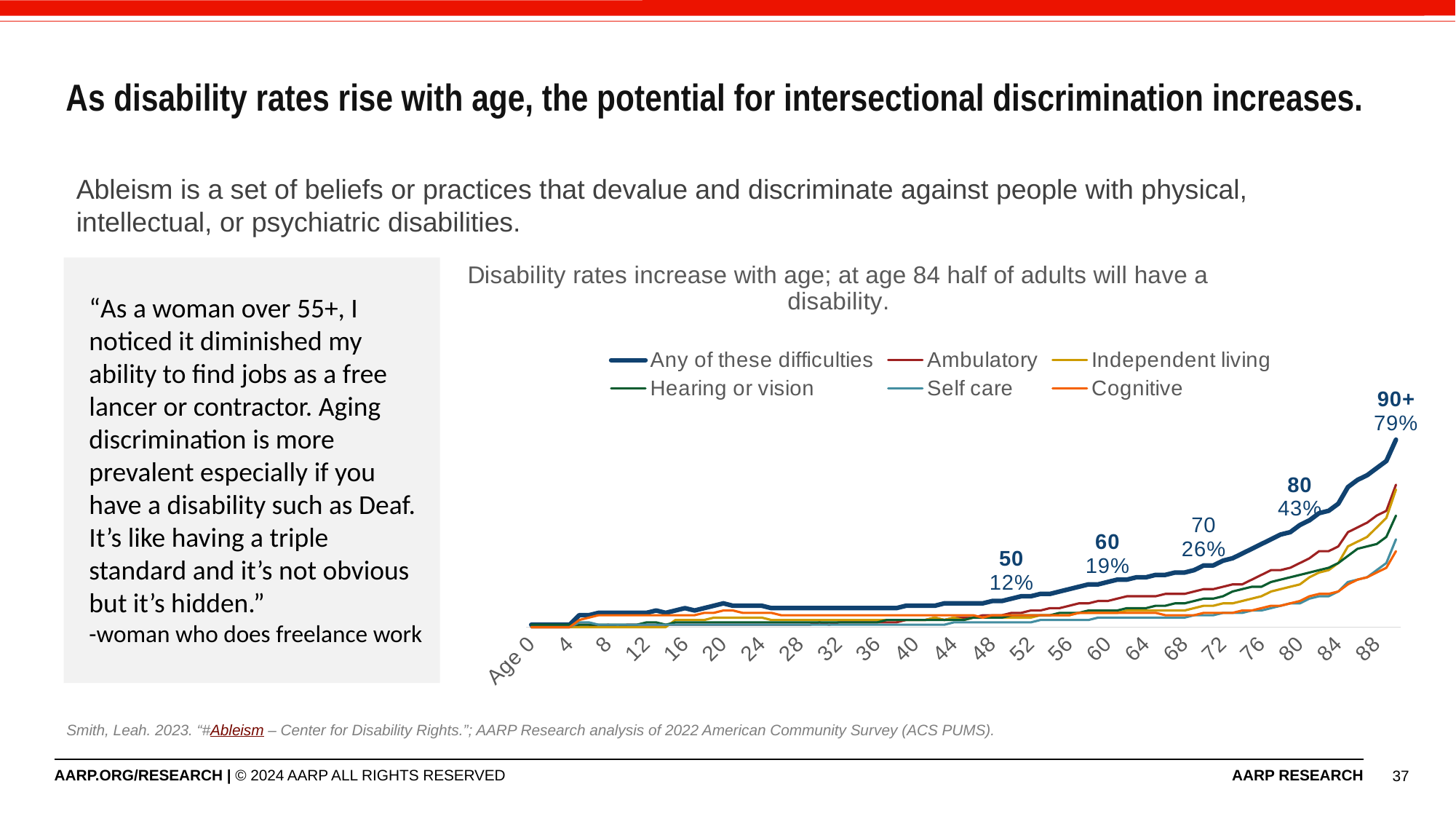
At age 88, which series is higher: Ambulatory or Self care? Ambulatory What is the value for 'Any of these difficulties' at age 50? 12% By how many percentage points does the 'Any of these difficulties' value at age 90+ exceed the value at age 80? 36 percentage points What is the title of the chart? Disability rates increase with age; at age 84 half of adults will have a disability. What is the value for 'Any of these difficulties' at age 90+? 79% Do the disability rates rise or fall as age increases along the x axis? Rise What is the value for 'Any of these difficulties' at age 60? 19% What is the value for 'Any of these difficulties' at age 70? 26% What kind of chart is shown on the slide? Line chart By how many percentage points does the 'Any of these difficulties' value at age 80 exceed the value at age 70? 17 percentage points What is the value for 'Any of these difficulties' at age 80? 43% How many series does the legend list? 6